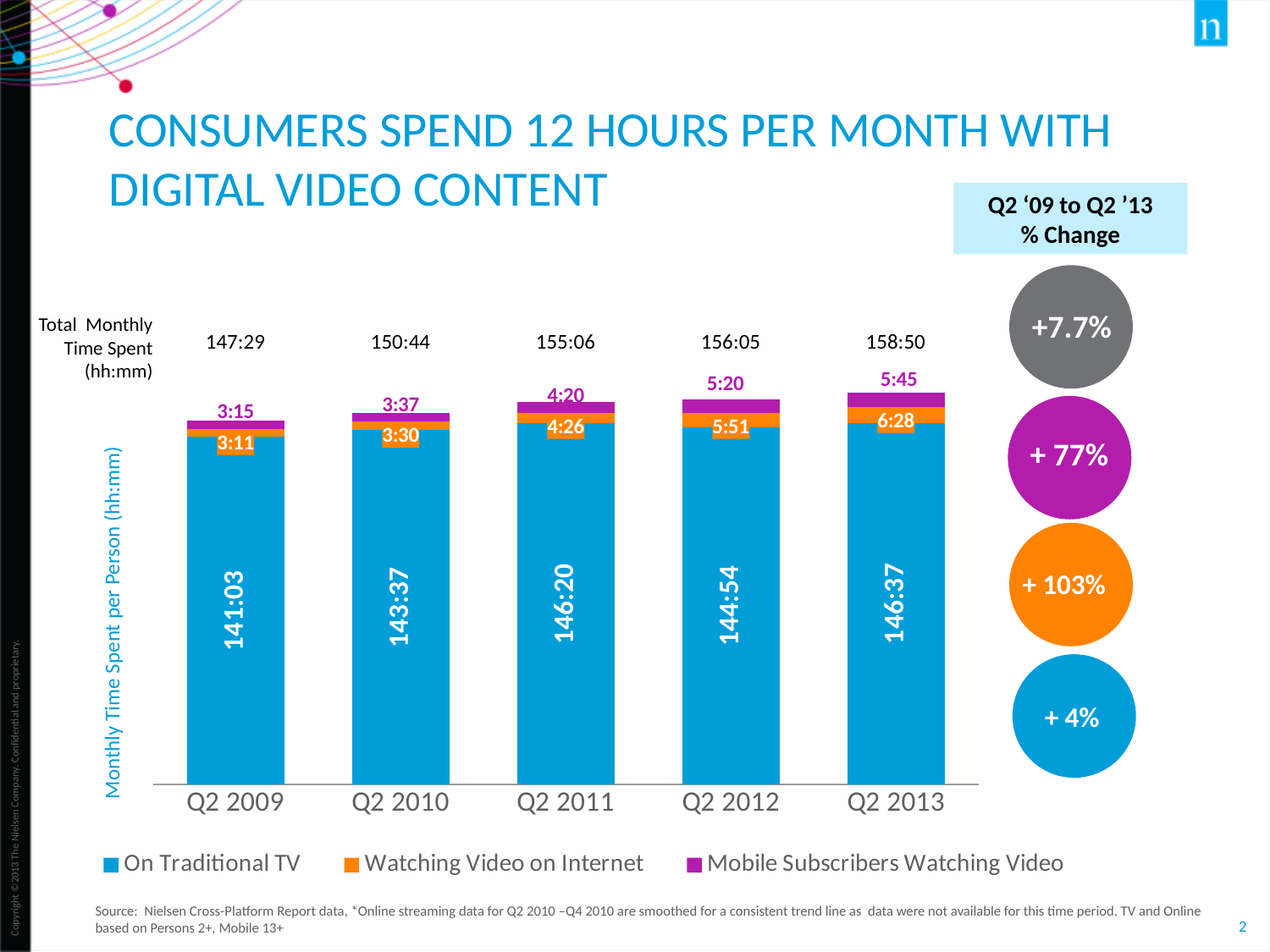
In which quarter is the Mobile Subscribers Watching Video value highest? Q2 2013 How many quarters are shown on the x axis? 5 What is the difference between the Watching Video on Internet values for Q2 2013 and Q2 2009? 3:17 In which quarter is the Watching Video on Internet value lowest? Q2 2009 What is the value for On Traditional TV in Q2 2011? 146:20 Which is larger for On Traditional TV: Q2 2010 or Q2 2012? Q2 2012 What is the value for Mobile Subscribers Watching Video in Q2 2009? 3:15 How many series does the legend list? 3 What is the Total Monthly Time Spent shown for Q2 2012? 156:05 What is the value for Watching Video on Internet in Q2 2013? 6:28 Does the Total Monthly Time Spent rise or fall from Q2 2009 to Q2 2013? Rise What kind of chart is shown on the slide? Stacked bar chart